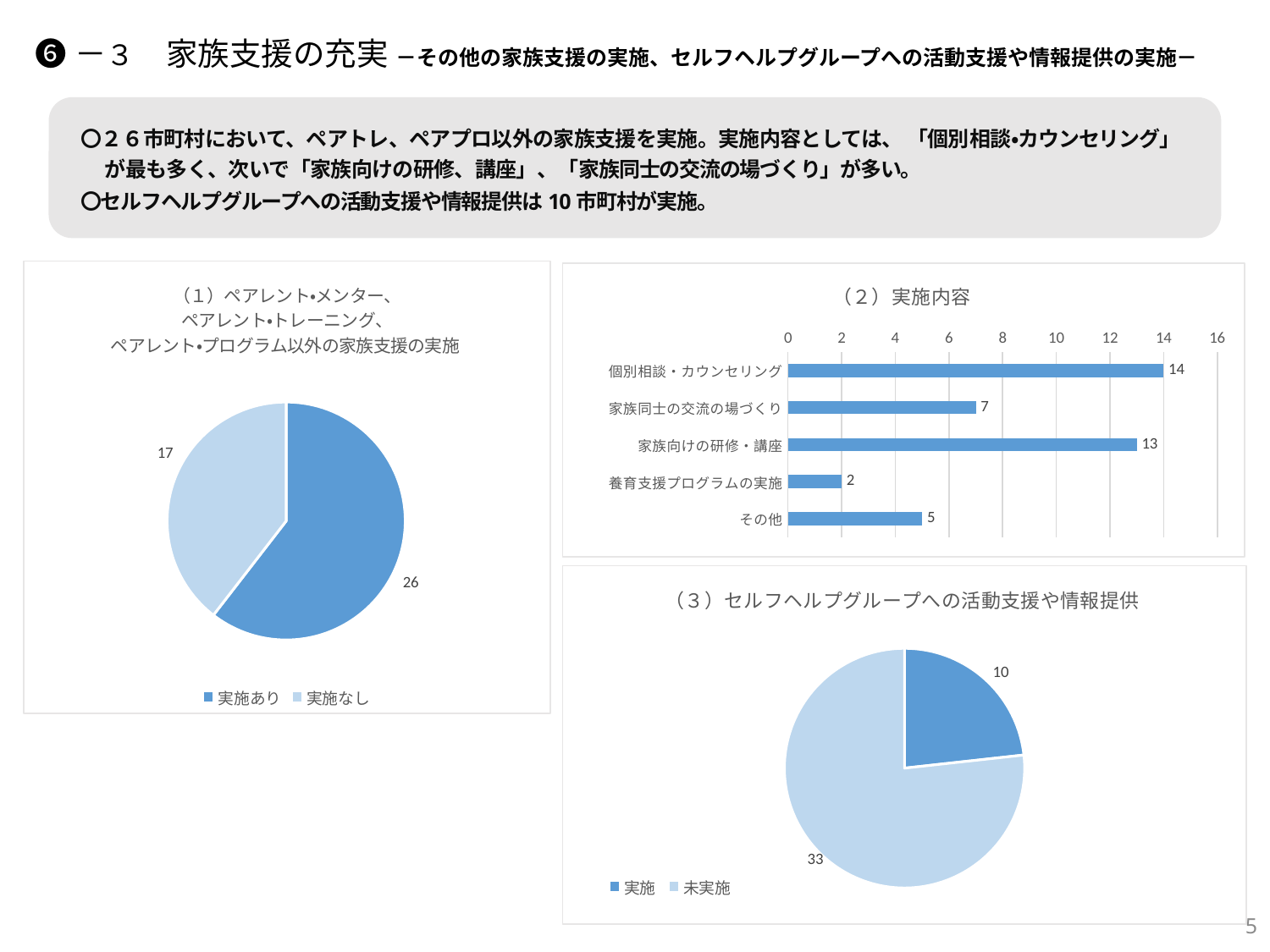
How many entries does the legend list in the chart titled （３）セルフヘルプグループへの活動支援や情報提供? 2 In the chart titled （２）実施内容, what is the difference between the values for 家族向けの研修・講座 and 家族同士の交流の場づくり? 6 What kind of chart is the chart titled （２）実施内容? bar chart In the chart titled （２）実施内容, what is the value for 養育支援プログラムの実施? 2 In the chart titled （３）セルフヘルプグループへの活動支援や情報提供, what is the value for 未実施? 33 In the pie chart on the left titled （１）, what is the value for 実施あり? 26 In the chart titled （２）実施内容, which category has the lowest value? 養育支援プログラムの実施 In the chart titled （２）実施内容, which is larger, the value for その他 or the value for 家族同士の交流の場づくり? 家族同士の交流の場づくり In the chart titled （２）実施内容, what is the value for 個別相談・カウンセリング? 14 In the pie chart on the left titled （１）, what is the total of the two slices? 43 How many categories are shown in the chart titled （２）実施内容? 5 In the chart titled （２）実施内容, which category has the highest value? 個別相談・カウンセリング